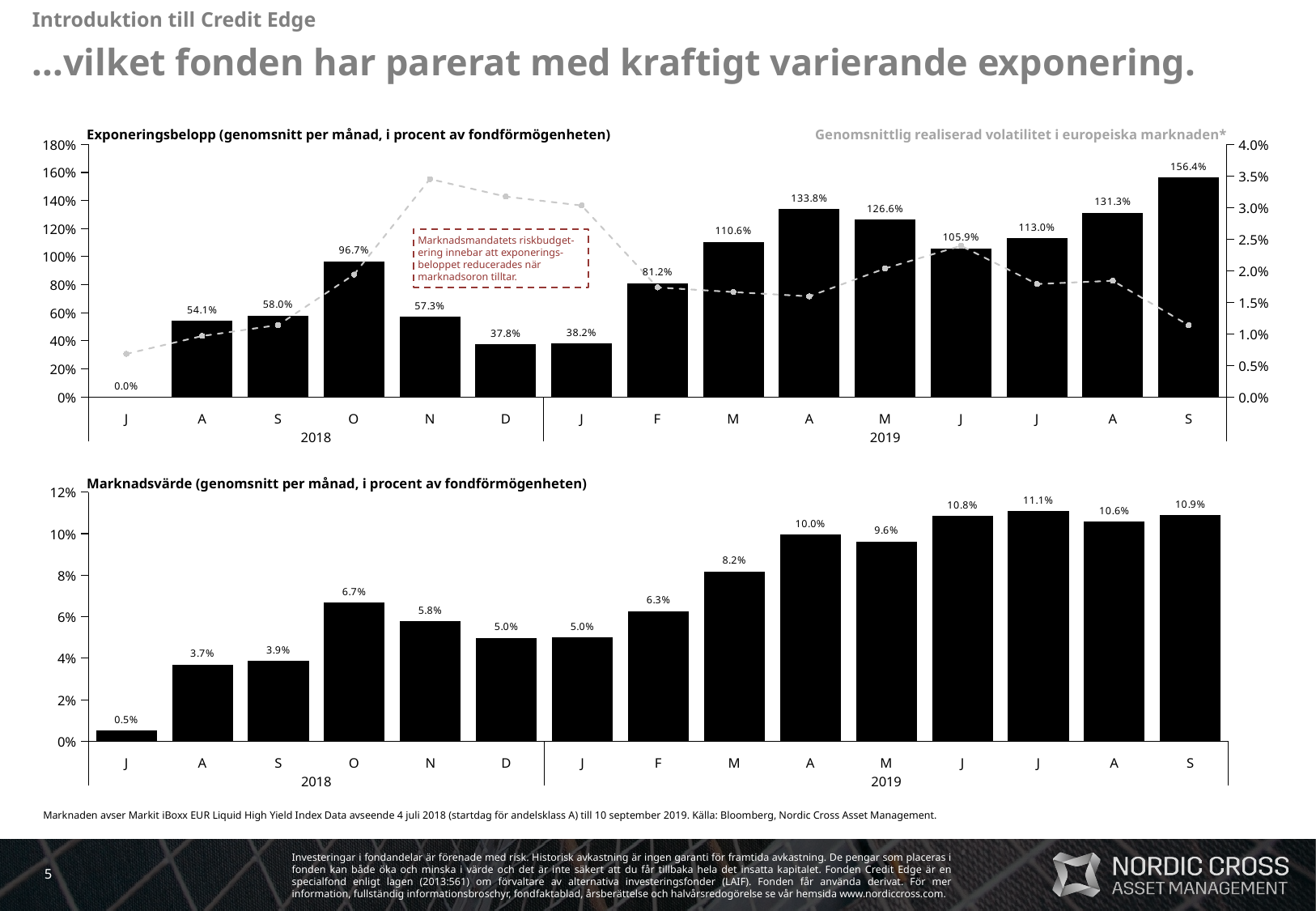
In the Exponeringsbelopp chart, is the dashed volatility line for N 2018 greater or less than 3.0% on the right-hand axis? greater What type of chart is the Marknadsvärde chart? Bar chart What is the title of the secondary-axis series shown as a dashed line in the top chart? Genomsnittlig realiserad volatilitet i europeiska marknaden* In the Marknadsvärde chart, what is the difference between the bars for O 2018 (6.7%) and N 2018 (5.8%)? 0.9% In the Exponeringsbelopp chart, which month has the highest bar? S 2019 (156.4%) In the Exponeringsbelopp chart, which is larger: the bar for F 2019 or the bar for D 2018? F 2019 (81.2%) In the Exponeringsbelopp chart, what is the value for October 2018 (O, 2018)? 96.7% In the Exponeringsbelopp chart, what is the difference between the bars for A 2019 (133.8%) and M 2019 (126.6%)? 7.2% In the Exponeringsbelopp chart, how many monthly bars are plotted? 15 In the Marknadsvärde chart, which month has the lowest bar? J 2018 (0.5%) In the Marknadsvärde chart, what is the value for M 2019 (March)? 8.2% In the Marknadsvärde chart, which month has the highest bar? J 2019 (11.1%)